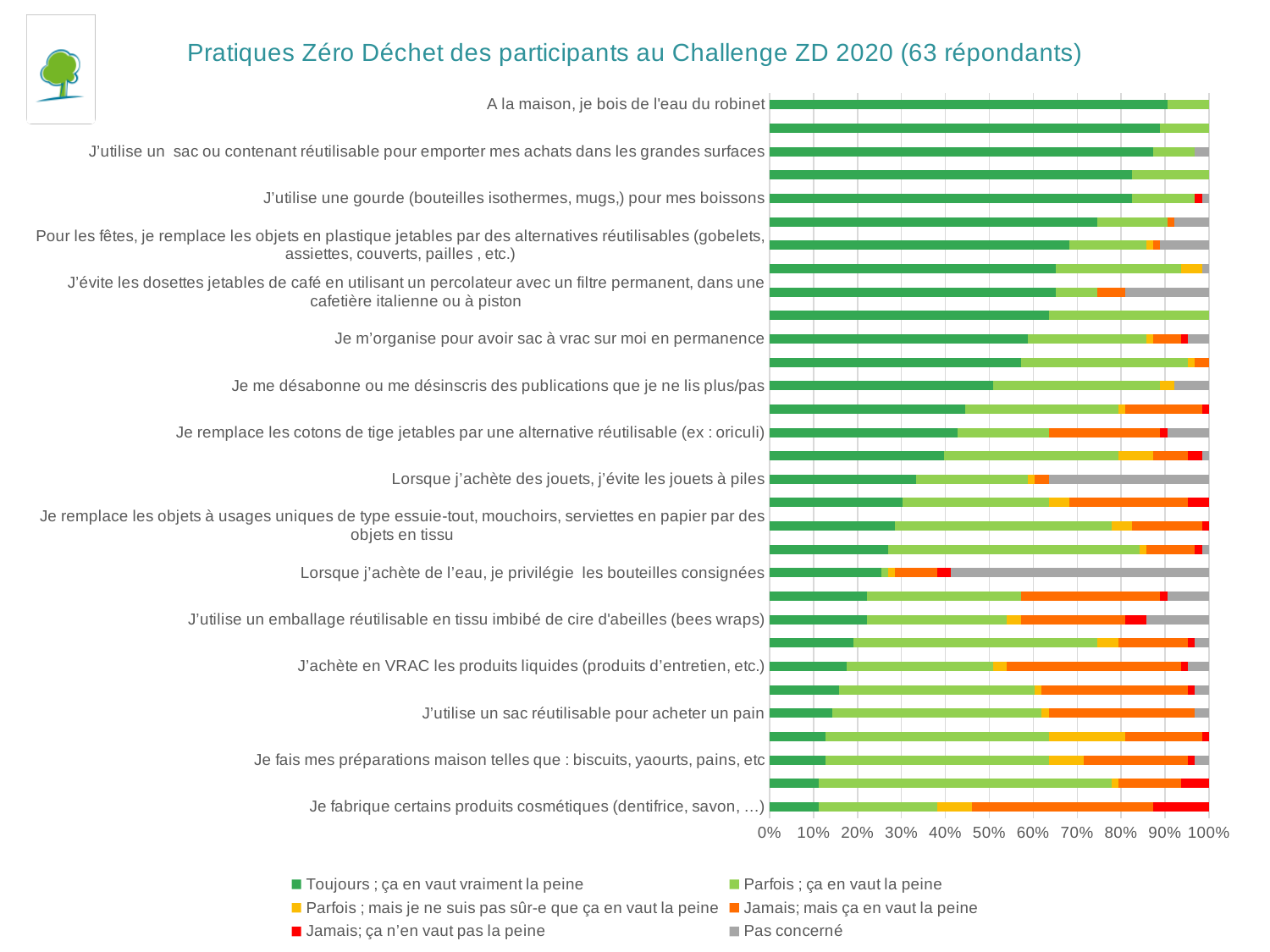
Is the "Toujours ; ça en vaut vraiment la peine" share for "Je fabrique certains produits cosmétiques (dentifrice, savon, …)" greater or less than 20%? less Is the "Toujours ; ça en vaut vraiment la peine" share for "J'utilise une gourde (bouteilles isothermes, mugs,) pour mes boissons" greater or less than 70%? greater What is the title of the chart? Pratiques Zéro Déchet des participants au Challenge ZD 2020 (63 répondants) Which has a larger "Toujours ; ça en vaut vraiment la peine" share: "Je me désabonne ou me désinscris des publications que je ne lis plus/pas" or "Je remplace les cotons de tige jetables par une alternative réutilisable (ex : oriculi)"? Je me désabonne ou me désinscris des publications que je ne lis plus/pas Which category has the largest share of "Toujours ; ça en vaut vraiment la peine"? A la maison, je bois de l'eau du robinet Is the "Toujours ; ça en vaut vraiment la peine" share for "A la maison, je bois de l'eau du robinet" greater or less than 80%? greater How many series does the legend list? 6 Which colour represents the series "Pas concerné" in the legend? Grey What kind of chart is shown on the slide? Stacked bar chart Moving down the chart from the top category to the bottom category, does the "Toujours ; ça en vaut vraiment la peine" share rise or fall? Fall